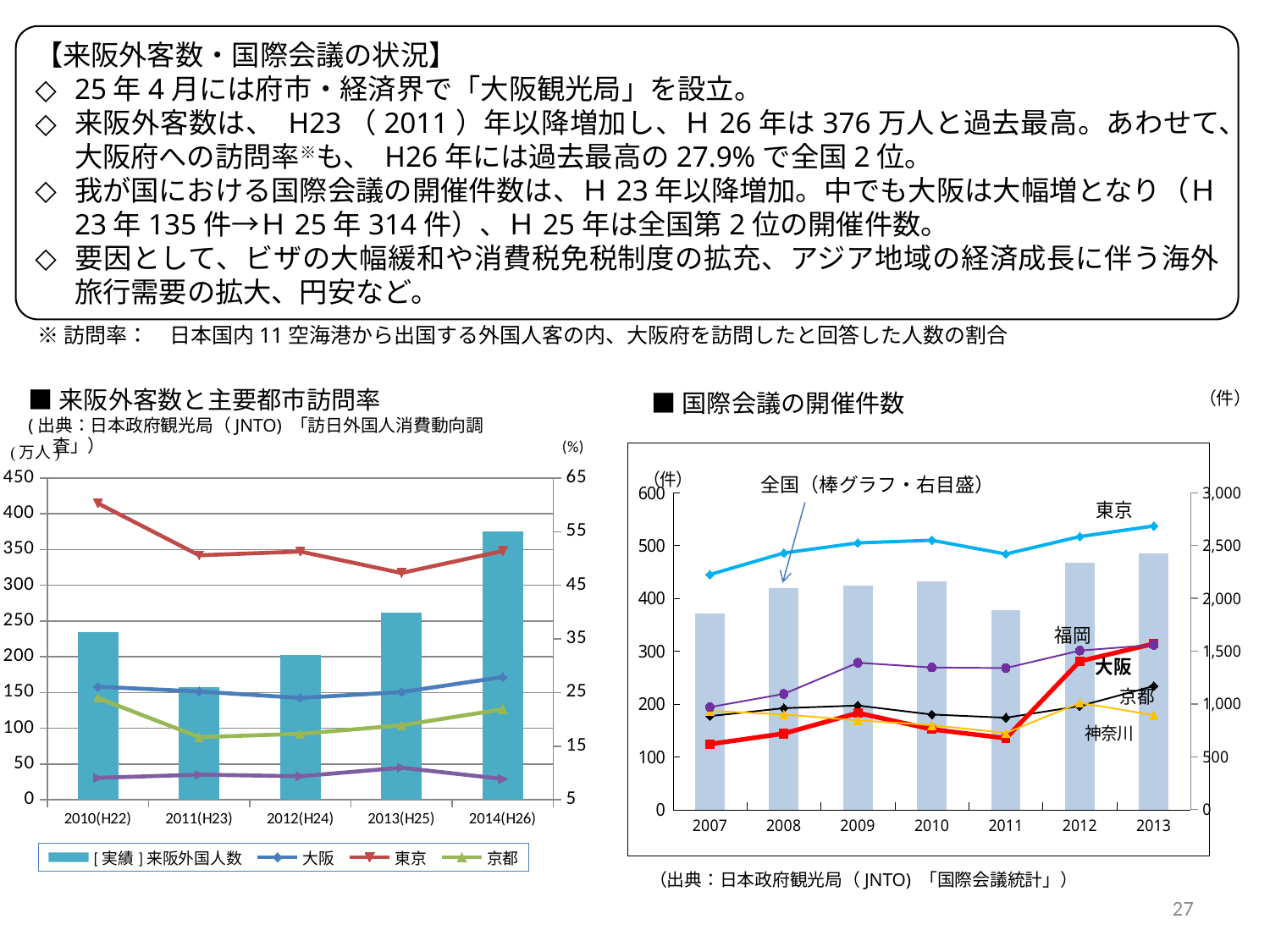
In the right chart (国際会議の開催件数), is the value for 大阪 in 2007 greater or less than 200? less In the right chart (国際会議の開催件数), which is larger in 2013, 大阪 or 京都? 大阪 In the left chart (来阪外客数と主要都市訪問率), how many series does the legend list? 4 In the left chart (来阪外客数と主要都市訪問率), which year has the shortest 来阪外国人数 bar? 2011(H23) In the left chart (来阪外客数と主要都市訪問率), which city line has the highest visit rate in 2010(H22)? 東京 In the right chart (国際会議の開催件数), how many years are shown on the x axis? 7 In the left chart (来阪外客数と主要都市訪問率), how many years are shown on the x axis? 5 In the right chart (国際会議の開催件数), which city line is highest in 2013? 東京 In the left chart (来阪外客数と主要都市訪問率), do the 来阪外国人数 bars rise or fall from 2011(H23) to 2014(H26)? rise In the left chart (来阪外客数と主要都市訪問率), which year has the tallest 来阪外国人数 bar? 2014(H26) In the left chart (来阪外客数と主要都市訪問率), is the 来阪外国人数 bar for 2014(H26) greater or less than 350? greater What kind of chart is the left chart titled 来阪外客数と主要都市訪問率? A combined bar and line chart